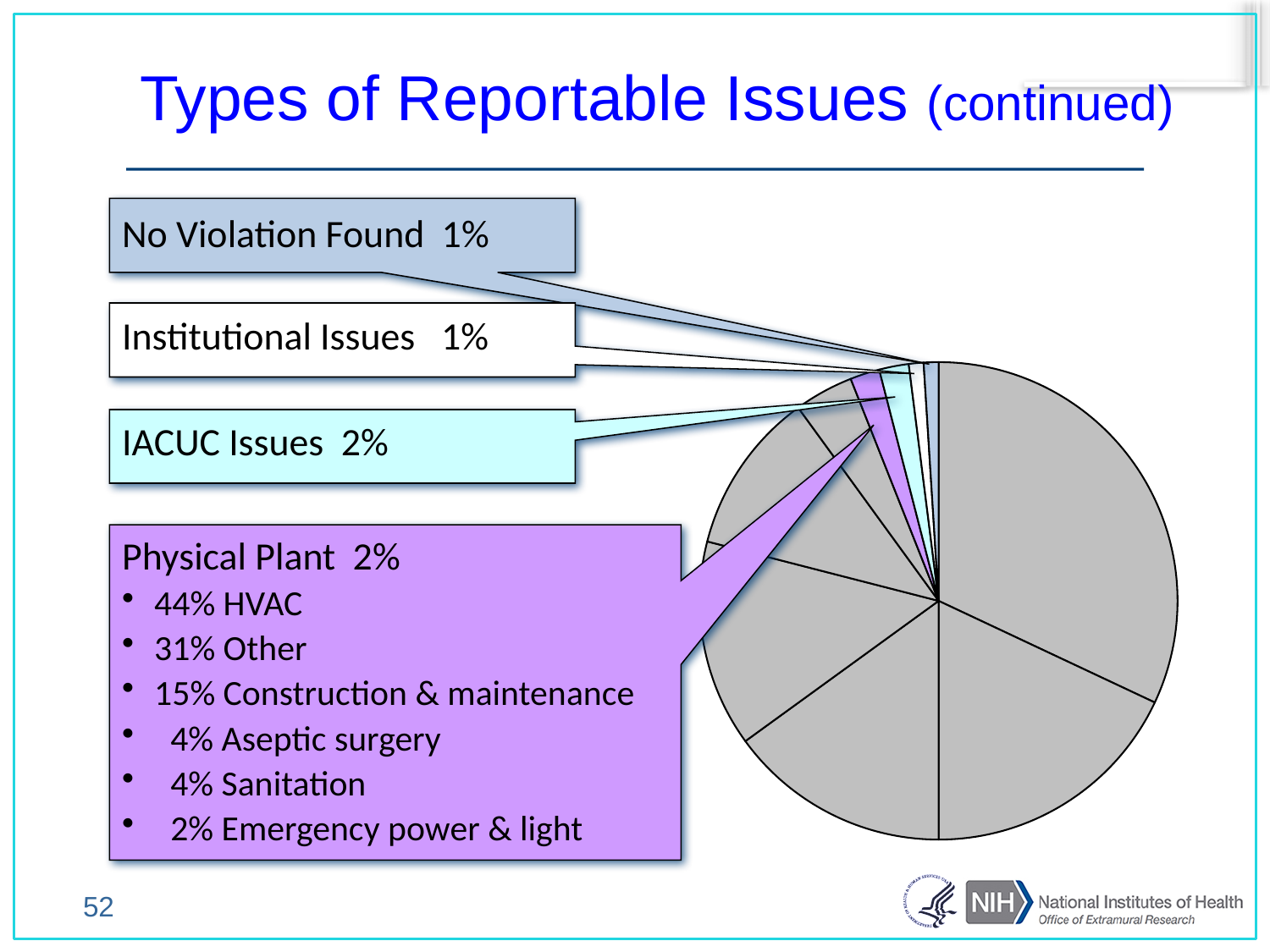
What share of the pie is labeled as IACUC Issues? 2% What is the difference between the Physical Plant share and the No Violation Found share? 1% What share of the pie is labeled as Physical Plant? 2% Within the Physical Plant breakdown, what percentage is attributed to HVAC? 44% Within the Physical Plant breakdown, which item has the smallest percentage? Emergency power & light What colour is the Physical Plant slice of the pie? purple What share of the pie is labeled as Institutional Issues? 1% How many items are listed in the Physical Plant breakdown? 6 Within the Physical Plant breakdown, what percentage is attributed to Construction & maintenance? 15% What kind of chart is shown on the slide? pie chart Which is larger, the IACUC Issues share or the Institutional Issues share? IACUC Issues